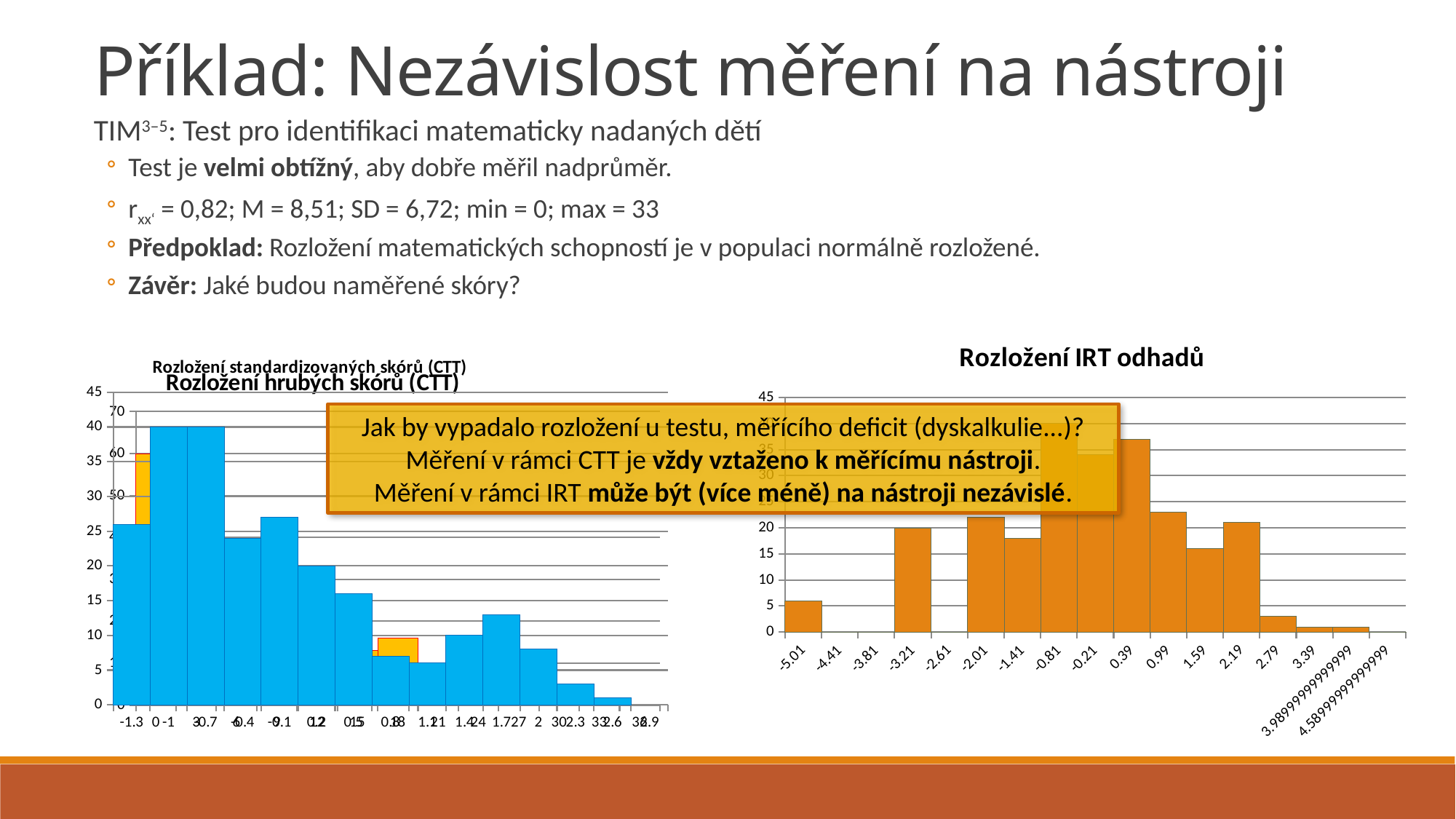
In the 'Rozložení IRT odhadů' chart, is the value for 0.99 greater or less than 20? greater In the 'Rozložení IRT odhadů' chart, is the value for -1.41 greater or less than 20? less In the 'Rozložení IRT odhadů' chart, which category has the highest bar? -0.81 In the 'Rozložení IRT odhadů' chart, is the value for 0.39 greater or less than 35? greater In the 'Rozložení IRT odhadů' chart, which is larger, the value for -5.01 or the value for -3.21? -3.21 In the 'Rozložení IRT odhadů' chart, which is larger, the value for 0.99 or the value for 1.59? 0.99 How many category labels are shown on the x axis of the 'Rozložení IRT odhadů' chart? 17 What colour are the bars in the 'Rozložení IRT odhadů' chart? orange What kind of chart is the 'Rozložení IRT odhadů' chart on the right of the slide? bar chart